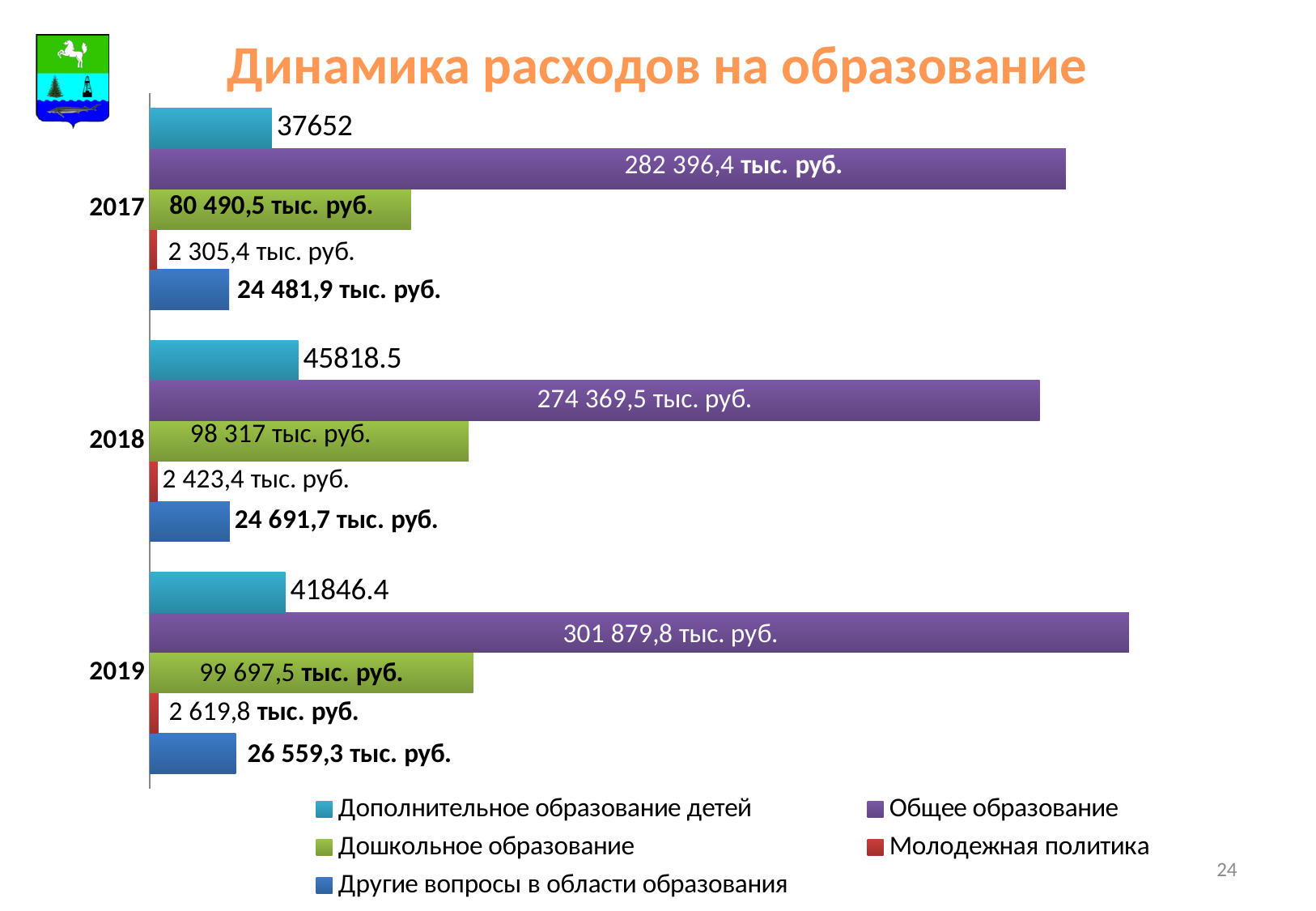
Do the values for Молодежная политика rise or fall from 2017 to 2019? rise By how much did Общее образование increase from 2017 to 2019? 19 483,4 тыс. руб. What is the value for Общее образование in 2019? 301 879,8 тыс. руб. In which year is the value for Общее образование the highest? 2019 Which series has the lowest value in 2017? Молодежная политика How many years (categories) are shown on the chart? 3 What is the value for Молодежная политика in 2019? 2 619,8 тыс. руб. What is the value for Дополнительное образование детей in 2018? 45818.5 What is the value for Дошкольное образование in 2017? 80 490,5 тыс. руб. What type of chart is shown on the slide? bar chart How many series does the legend list? 5 Which is larger: Дополнительное образование детей in 2018 or in 2019? 2018